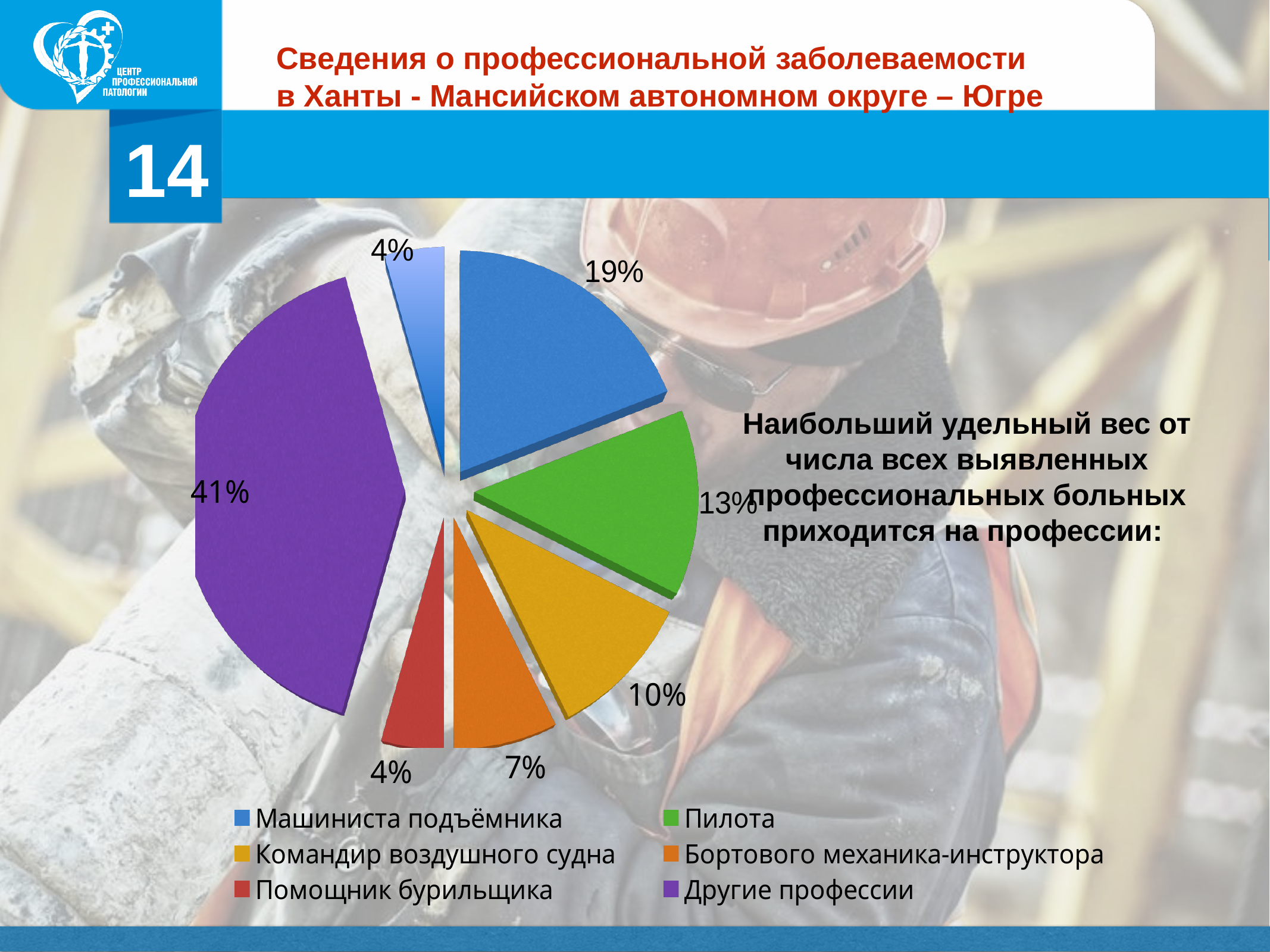
What share of the pie is labelled for Машиниста подъёмника? 19% Which category has the largest slice of the pie? Другие профессии What share of the pie is labelled for Помощник бурильщика? 4% What colour is the slice for Другие профессии? Purple How many entries does the legend list? 6 What is the difference in percentage points between Другие профессии and Машиниста подъёмника? 22 What type of chart is shown on the slide? Pie chart What share of the pie is labelled for Командир воздушного судна? 10% What share of the pie is labelled for Бортового механика-инструктора? 7% Which slice is larger: Пилота or Командир воздушного судна? Пилота How many slices does the pie chart have? 7 What share of the pie is labelled for Пилота? 13%